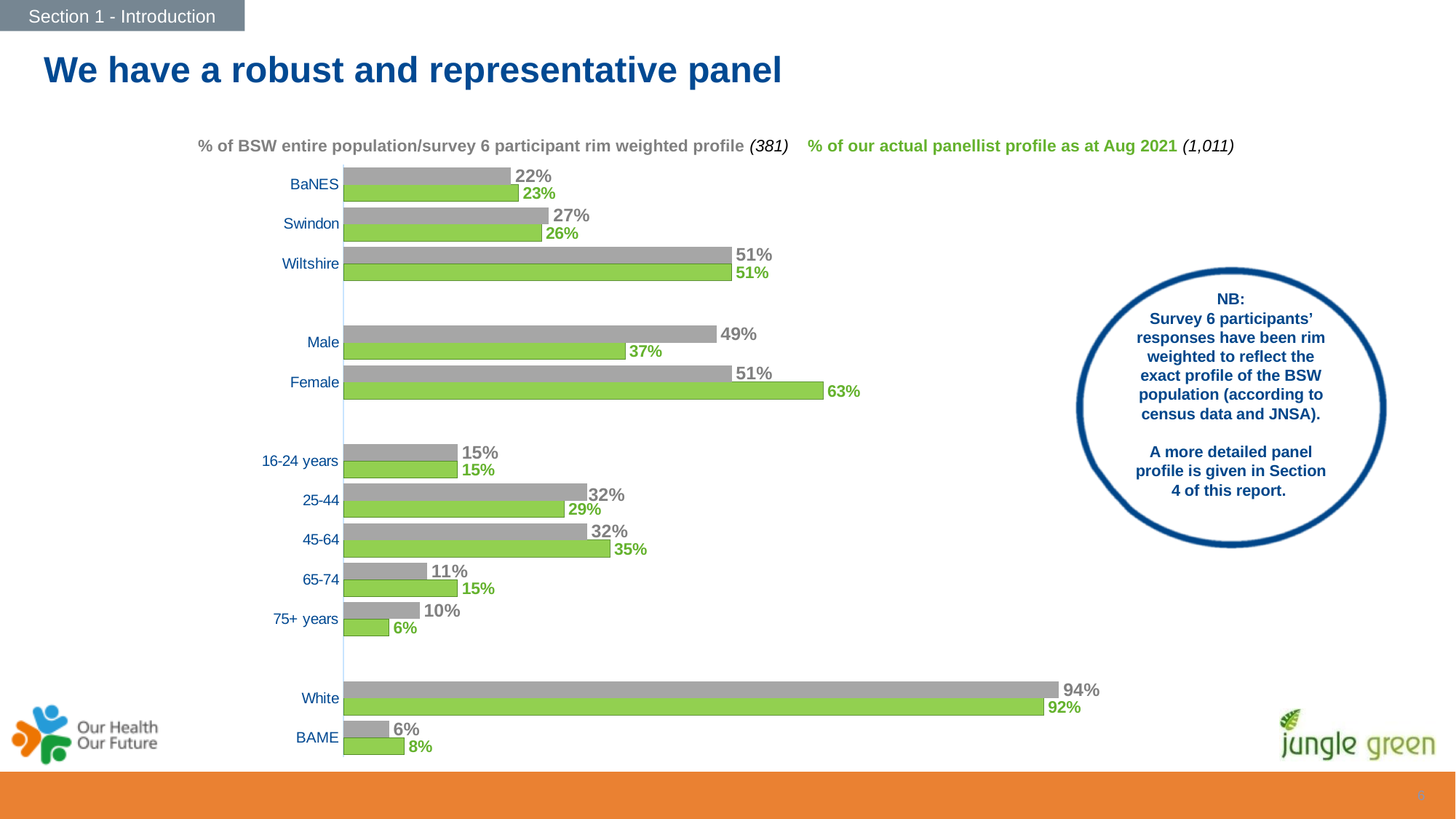
Which category has the lowest value in the actual panellist profile as at Aug 2021 series? 75+ years What is the difference between the Male values in the BSW population profile series and the actual panellist profile series? 12% What is the value for 65-74 in the actual panellist profile as at Aug 2021 series? 15% What is the difference between the White and BAME values in the actual panellist profile as at Aug 2021 series? 84% How many series does the chart show? 2 What kind of chart is shown on the slide? bar chart What is the value for Male in the BSW entire population/survey 6 participant rim weighted profile series? 49% Which category has the highest value in the BSW entire population/survey 6 participant rim weighted profile series? White How many categories are plotted on the chart? 12 For 45-64, which series has the larger value: the BSW population profile or the actual panellist profile? actual panellist profile What colour are the bars for the actual panellist profile as at Aug 2021 series? green What is the value for Female in the actual panellist profile as at Aug 2021 series? 63%